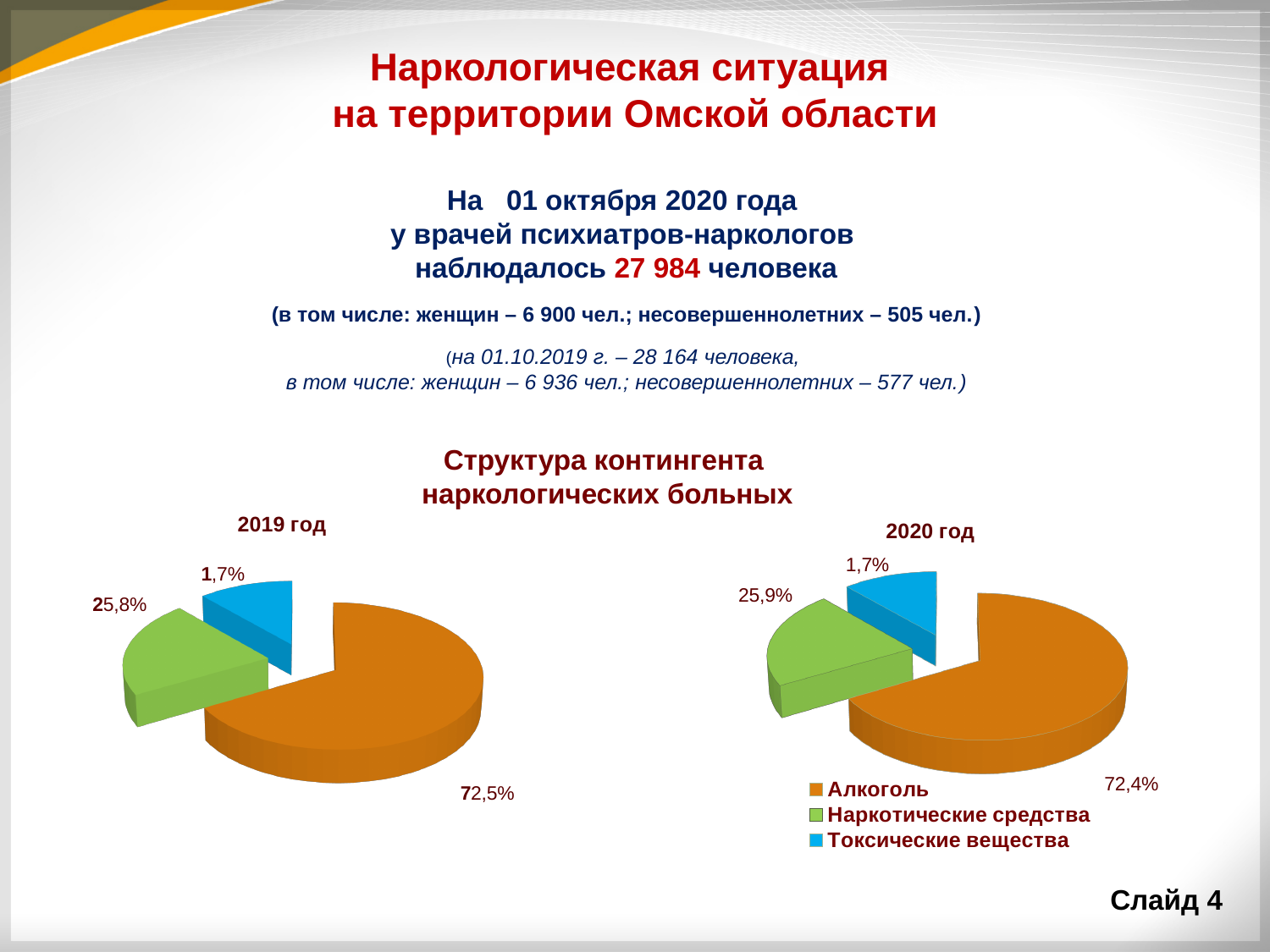
In the 2019 год pie chart, which category has the largest slice? Алкоголь How many entries does the legend list? 3 In the 2020 год pie chart, what is the difference between the Алкоголь share and the Наркотические средства share? 46,5% In the 2019 год pie chart, what share is shown for Наркотические средства? 25,8% What colour represents Токсические вещества in the pie charts? Blue In the 2020 год pie chart, what share is shown for Наркотические средства? 25,9% What type of chart is used for the 2020 год data? Pie chart Which is larger: the Алкоголь share in the 2019 год chart or in the 2020 год chart? 2019 год How many slices does the 2019 год pie chart have? 3 In the 2020 год pie chart, which category has the smallest slice? Токсические вещества In the 2019 год pie chart, what share is shown for Алкоголь? 72,5% In the 2020 год pie chart, what share is shown for Токсические вещества? 1,7%